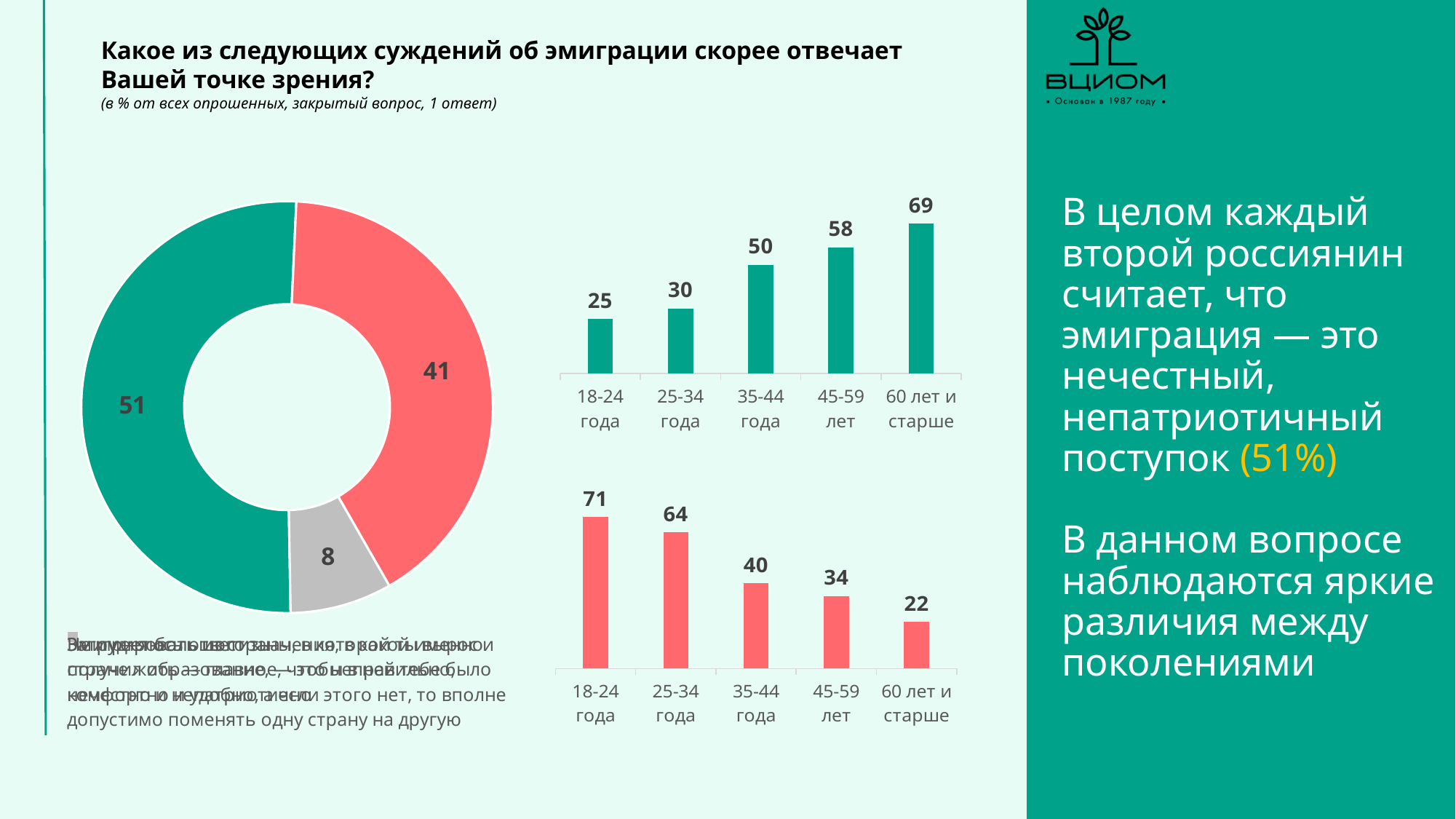
In the lower bar chart on the slide, which age group has the lowest value? 60 лет и старше In the upper bar chart on the slide, which age group has the highest value? 60 лет и старше In the upper bar chart on the slide, what is the value for the 60 лет и старше group? 69 In the lower bar chart on the slide, do the values rise or fall from the youngest to the oldest age group? fall What type of chart is shown on the left of the slide? donut chart In the lower bar chart on the slide, what is the value for the 25-34 года group? 64 In the donut chart on the left of the slide, what is the value of the largest segment? 51 In the upper bar chart on the slide, do the values rise or fall from the youngest to the oldest age group? rise In the upper bar chart on the slide, what is the value for the 18-24 года group? 25 In the lower bar chart on the slide, what is the difference between the values for 18-24 года and 45-59 лет? 37 In the upper bar chart on the slide, is the value for 35-44 года larger or smaller than the value for 45-59 лет? smaller How many age groups are shown in the lower bar chart on the slide? 5